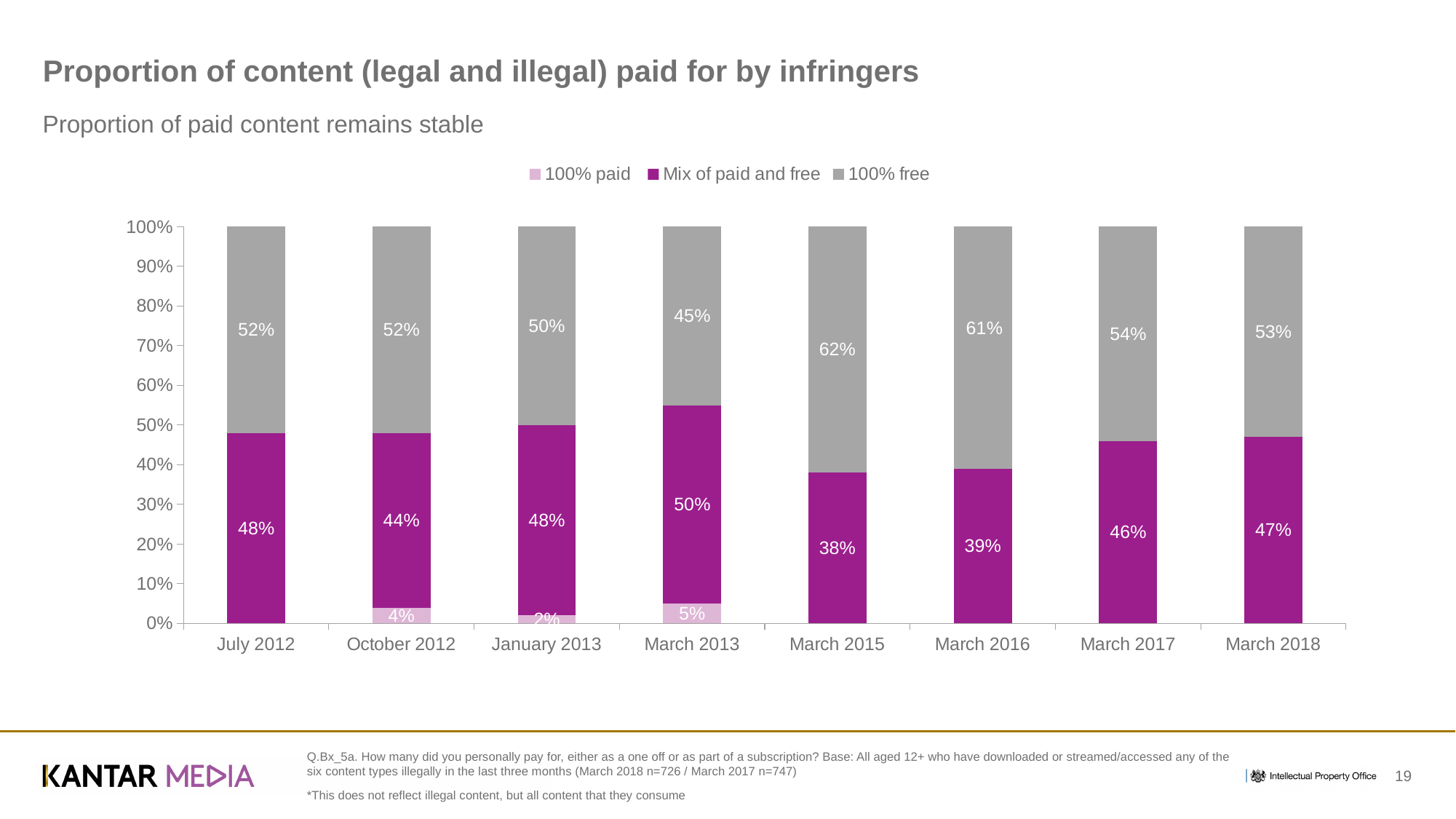
How many series does the legend list? 3 What is the difference between the '100% free' values for March 2015 and March 2018? 9 percentage points Is the 'Mix of paid and free' value for March 2017 greater or less than 40%? greater How many time periods are shown on the x axis? 8 What is the subtitle shown below the chart title? Proportion of paid content remains stable What is the value for '100% paid' in March 2013? 5% What is the value for '100% free' in March 2015? 62% Which is larger: the 'Mix of paid and free' value in March 2013 or in March 2016? March 2013 In which period is the '100% free' share highest? March 2015 In which period is the 'Mix of paid and free' share lowest? March 2015 What kind of chart is shown on the slide? Stacked bar chart What is the value for 'Mix of paid and free' in March 2018? 47%